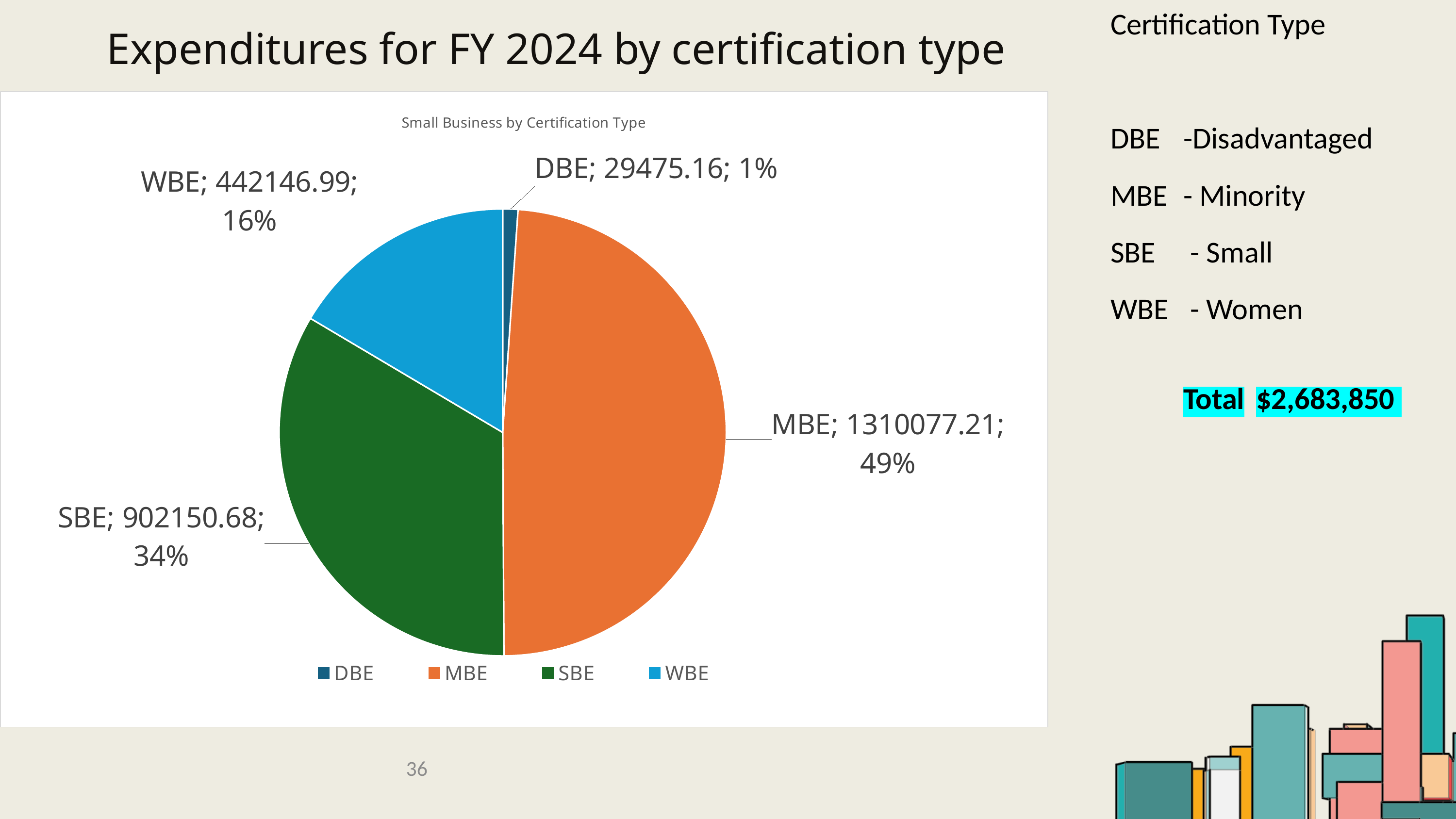
What kind of chart is shown on the slide? pie chart Which certification type has the smallest slice of the pie? DBE Which is larger, the value for WBE or the value for SBE? SBE What is the value for DBE in the pie chart? 29475.16 What is the value for MBE in the pie chart? 1310077.21 What share of the pie does WBE represent? 16% What is the value for SBE in the pie chart? 902150.68 What is the value for WBE in the pie chart? 442146.99 Which certification type has the largest slice of the pie? MBE How many categories does the legend of the pie chart list? 4 What is the difference between the MBE and SBE values? 407926.53 What share of the pie does SBE represent? 34%